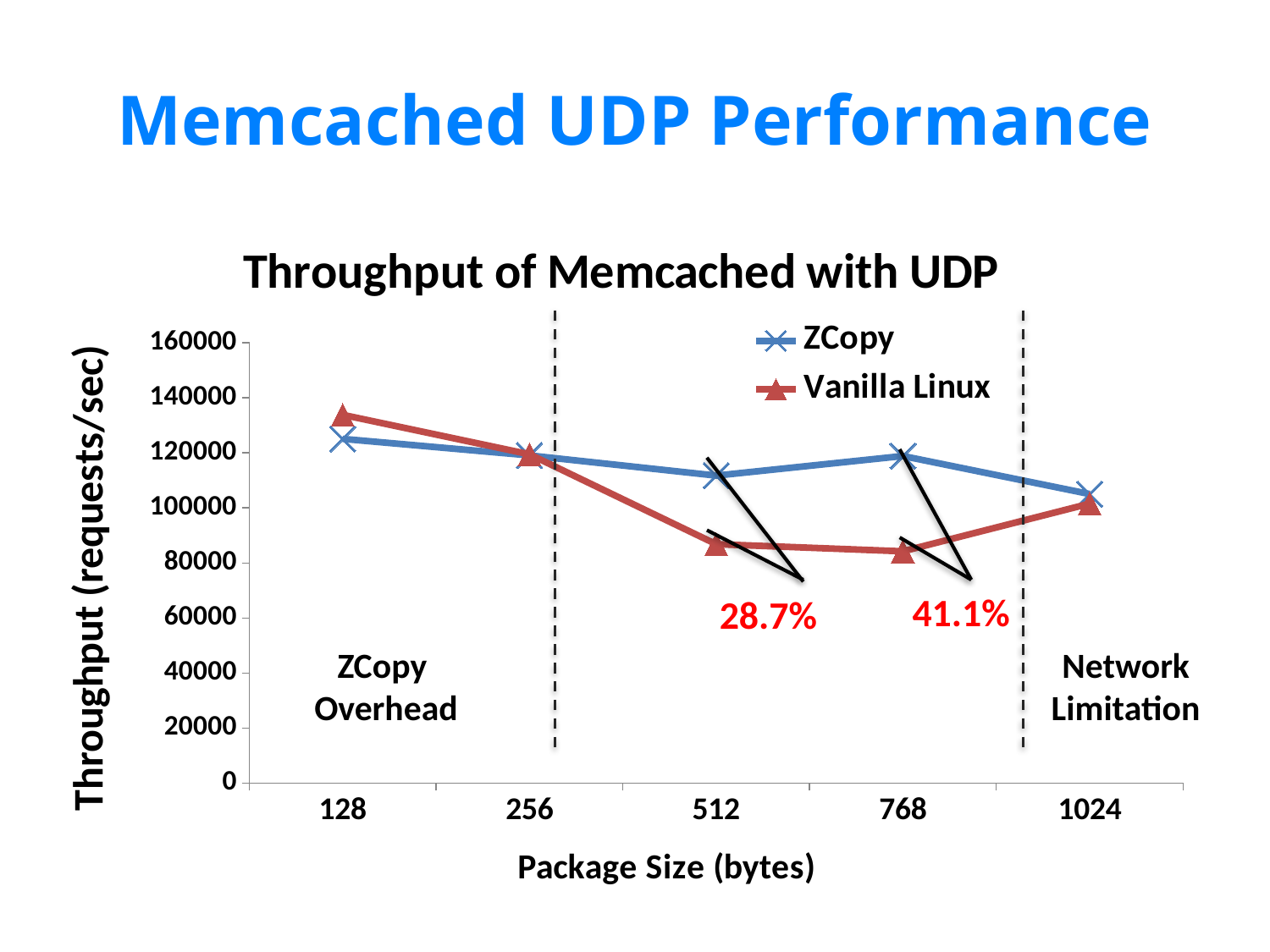
At which package size does Vanilla Linux reach its highest throughput? 128 At a package size of 128 bytes, which series has the higher throughput, ZCopy or Vanilla Linux? Vanilla Linux Is the ZCopy throughput at 1024 bytes greater or less than 120000? less How many package sizes are plotted along the x axis? 5 How many series does the legend list? 2 Is the ZCopy throughput at 512 bytes greater or less than 100000? greater At a package size of 512 bytes, which series has the higher throughput, ZCopy or Vanilla Linux? ZCopy Does the Vanilla Linux throughput rise or fall from 128 bytes to 768 bytes? fall What kind of chart is shown on the slide? line chart Is the Vanilla Linux throughput at 512 bytes greater or less than 100000? less What is the title of the chart? Throughput of Memcached with UDP